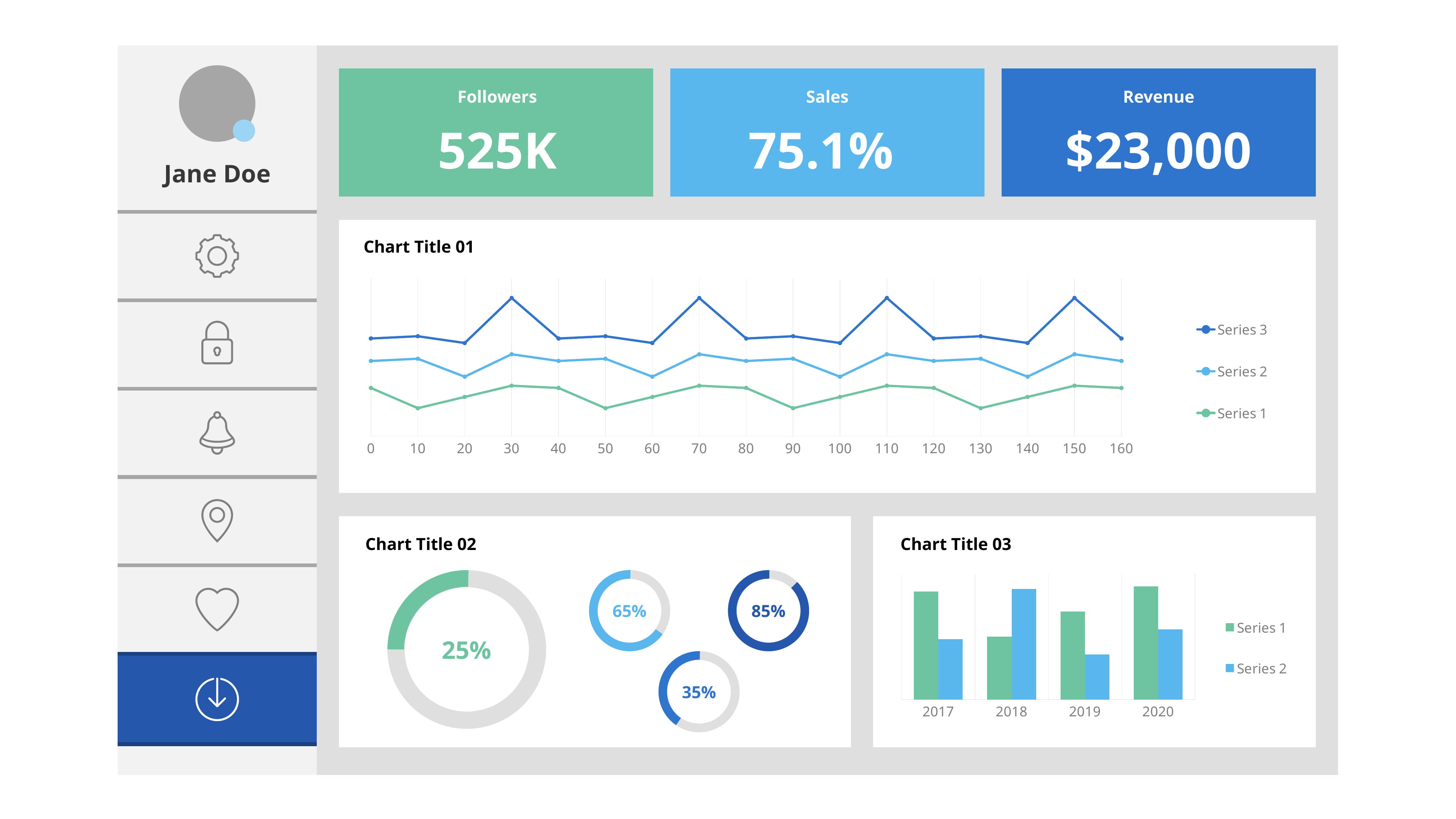
In Chart Title 03, which year has the highest Series 2 bar? 2018 What kind of chart is Chart Title 03? bar chart In Chart Title 01, which series has the highest values overall? Series 3 In Chart Title 01, which series has the lowest values overall? Series 1 What kind of chart is Chart Title 01? line chart In Chart Title 02, which ring shows the largest percentage? 85% How many series does the legend of Chart Title 01 list? 3 How many ring charts are shown in Chart Title 02? 4 How many years are shown on the x axis of Chart Title 03? 4 In Chart Title 02, what percentage is shown in the large green ring? 25% In Chart Title 02, what is the difference between the largest and smallest percentages shown? 60% In Chart Title 03, which is larger for 2017, Series 1 or Series 2? Series 1